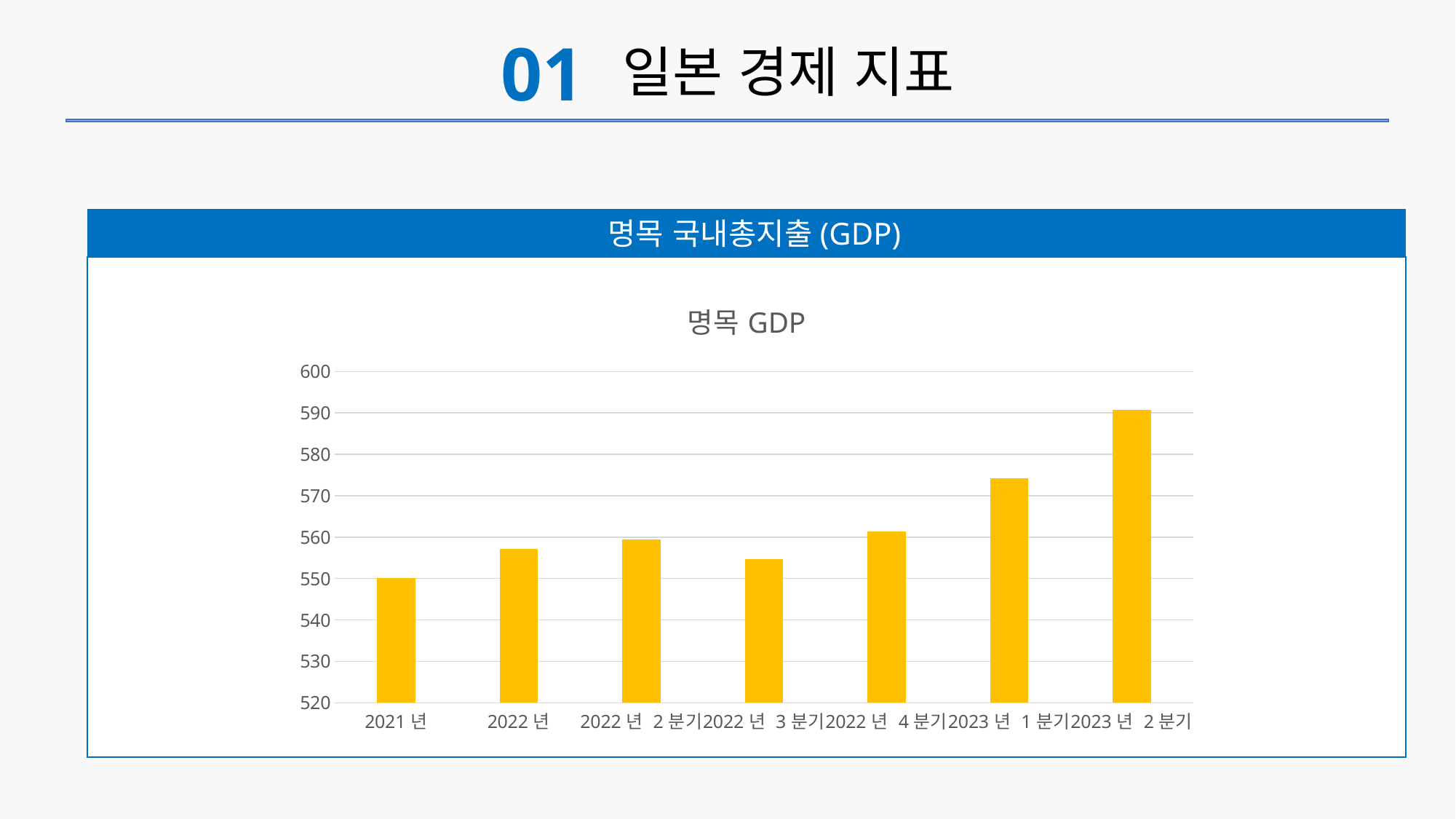
Overall, do the values rise or fall from 2021 년 to 2023 년 2 분기? Rise Is the value for 2021 년 greater or less than 560? less Is the value for 2023 년 1 분기 greater or less than 570? greater What is the title of the chart? 명목 GDP Which is larger, the value for 2022 년 2 분기 or the value for 2022 년 3 분기? 2022 년 2 분기 Is the value for 2022 년 3 분기 greater or less than 560? less What kind of chart is shown on the slide? Bar chart Which category has the highest value in the chart? 2023 년 2 분기 Which category has the lowest value in the chart? 2021 년 Which is larger, the value for 2023 년 1 분기 or the value for 2022 년 4 분기? 2023 년 1 분기 How many bars (categories) are plotted in the chart? 7